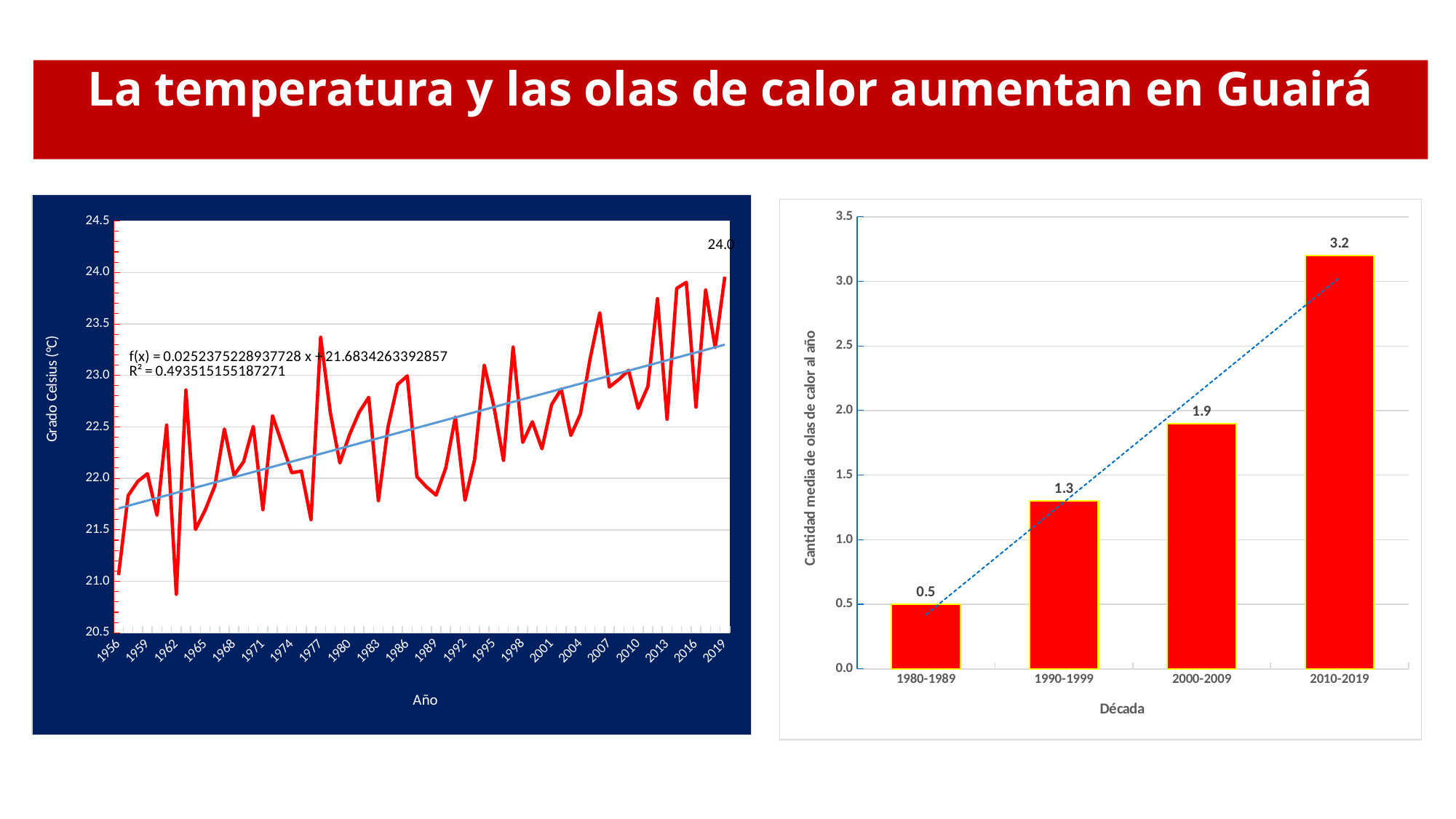
In the chart on the right, how many decades are shown on the x axis? 4 In the chart on the left, is the value for 1956 greater or less than 21.5? less In the chart on the right, what is the title of the x axis? Década What kind of chart is the chart on the left side of the slide? line chart In the chart on the right, do the values rise or fall from 1980-1989 to 2010-2019? rise In the chart on the right, what is the value for the decade 1980-1989? 0.5 In the chart on the right, which decade has the lowest value? 1980-1989 In the chart on the right, what is the value for the decade 2010-2019? 3.2 What kind of chart is the chart on the right side of the slide? bar chart In the chart on the right, what is the difference between the values for 2010-2019 and 1980-1989? 2.7 In the chart on the right, which decade has the highest value? 2010-2019 In the chart on the right, what is the value for the decade 1990-1999? 1.3